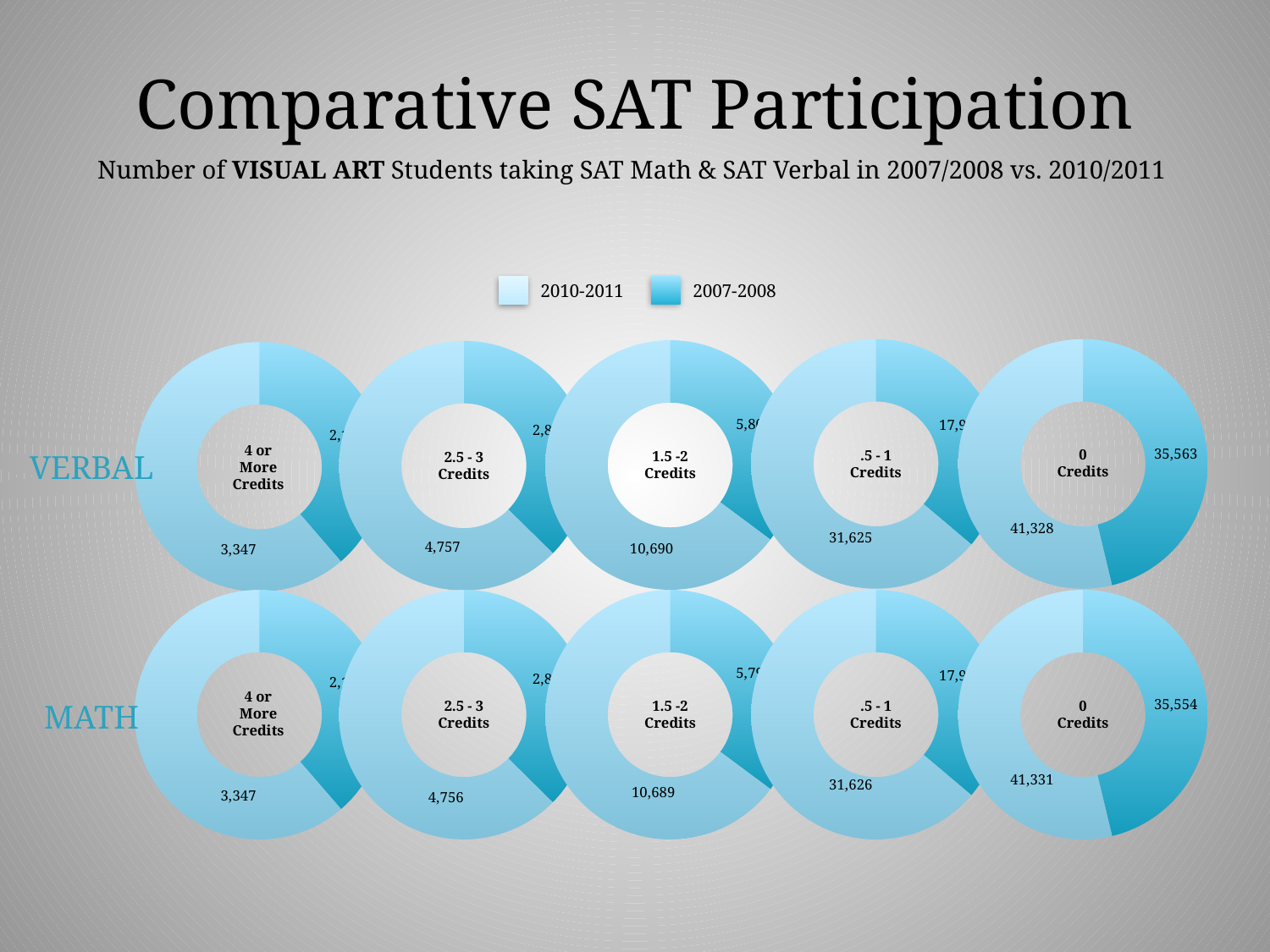
In the MATH row '0 Credits' donut chart, which series has the larger value, 2010-2011 or 2007-2008? 2010-2011 In the VERBAL row '0 Credits' donut chart, what is the difference between the 2010-2011 and 2007-2008 values? 5,765 In the MATH row, what is the 2010-2011 value on the '4 or More Credits' donut chart? 3,347 Across the MATH row, which credit category has the lowest 2010-2011 value? 4 or More Credits In the MATH row, what is the 2007-2008 value on the '0 Credits' donut chart? 35,554 How many series does the legend list? 2 Across the VERBAL row, which credit category has the highest 2010-2011 value? 0 Credits In the VERBAL row, what is the 2010-2011 value on the '1.5 -2 Credits' donut chart? 10,690 In the VERBAL row, what is the 2007-2008 value on the '0 Credits' donut chart? 35,563 In the VERBAL row, what is the 2010-2011 value on the '0 Credits' donut chart? 41,328 What kind of chart is used on this slide? Donut (pie) chart In the MATH row, what is the 2010-2011 value on the '.5 - 1 Credits' donut chart? 31,626